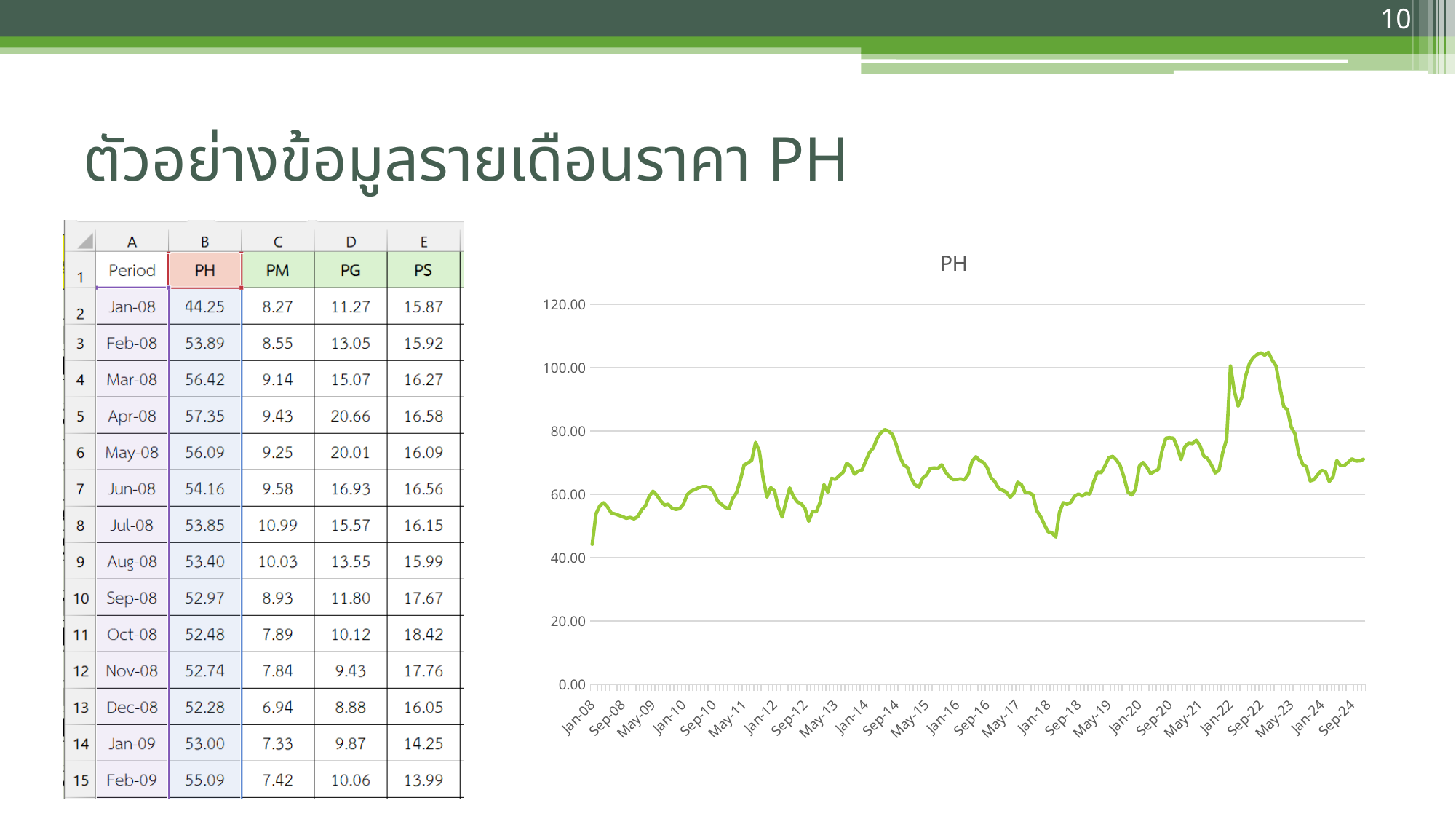
Is the PH value at Jan-08 greater or less than 60? less Which is larger, the PH value for Apr-08 or for Jan-08? Apr-08 What kind of chart is shown on the right of the slide? line chart What is the title of the chart? PH Is the PH value at Jan-18 greater or less than 60? less Is the highest PH value on the chart greater or less than 100? greater What is the PH value for Jan-08? 44.25 What is the PH value for Apr-08? 57.35 Overall, does the PH line rise or fall from Jan-08 to Sep-24? rise What is the PH value for Feb-09? 55.09 What is the difference between the PH values for Feb-08 and Jan-08? 9.64 What colour is the line in the PH chart? green